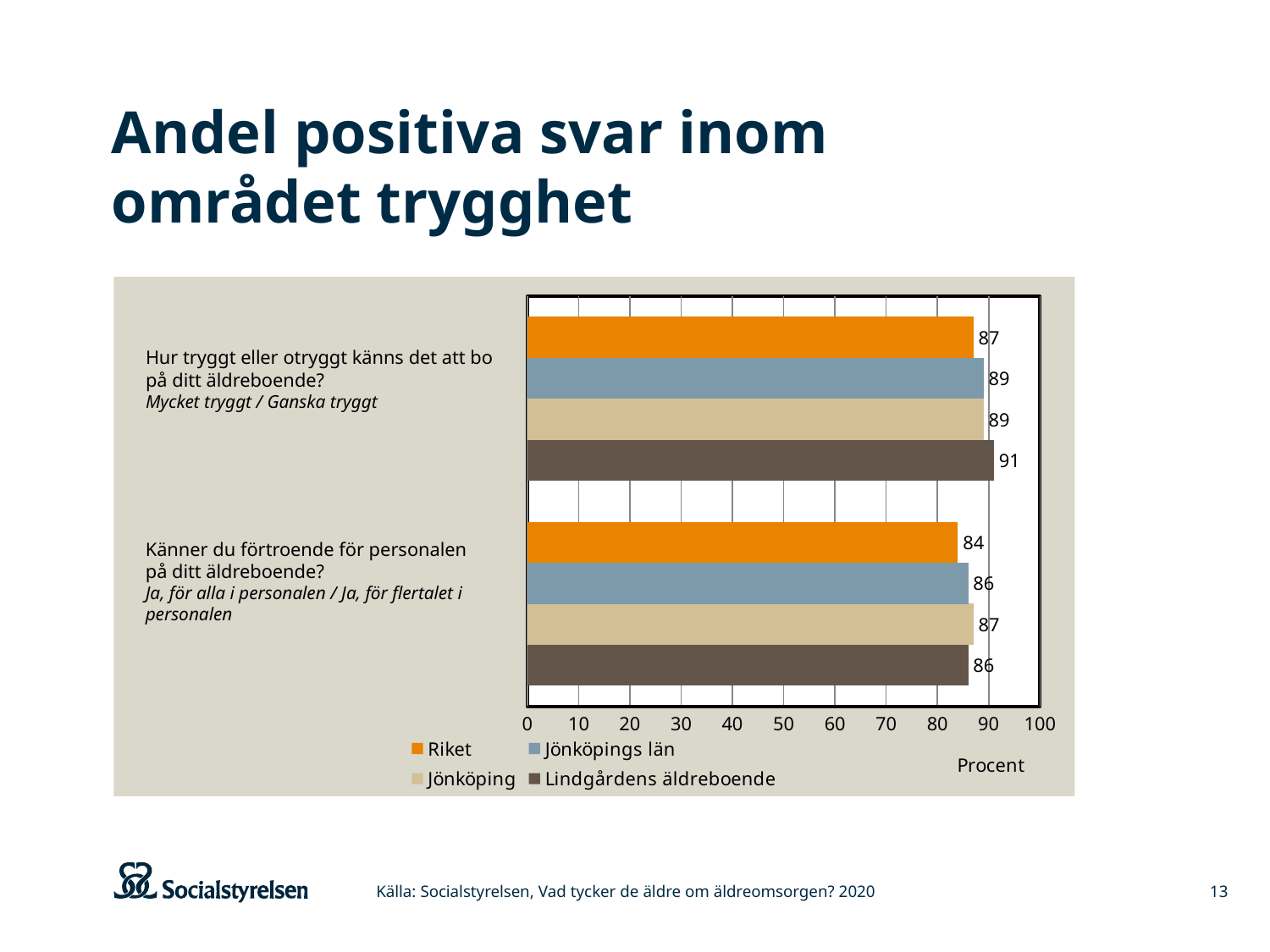
How many series does the legend list? 4 Which series has the highest value on the question "Hur tryggt eller otryggt känns det att bo på ditt äldreboende?"? Lindgårdens äldreboende What is the value for Riket on the question "Känner du förtroende för personalen på ditt äldreboende?"? 84 Which is larger for Lindgårdens äldreboende: the value for the trygghet question or the value for the förtroende question? The trygghet question (91) What type of chart is shown on the slide? Bar chart Is the value for Riket on the question "Känner du förtroende för personalen på ditt äldreboende?" greater or less than 90? less What is the value for Lindgårdens äldreboende on the question "Hur tryggt eller otryggt känns det att bo på ditt äldreboende?"? 91 What unit is shown on the x axis of the chart? Procent What is the difference between Lindgårdens äldreboende and Riket on the question "Hur tryggt eller otryggt känns det att bo på ditt äldreboende?"? 4 Which series has the lowest value on the question "Känner du förtroende för personalen på ditt äldreboende?"? Riket What is the value for Jönköping on the question "Känner du förtroende för personalen på ditt äldreboende?"? 87 How many questions (categories) are shown on the chart? 2